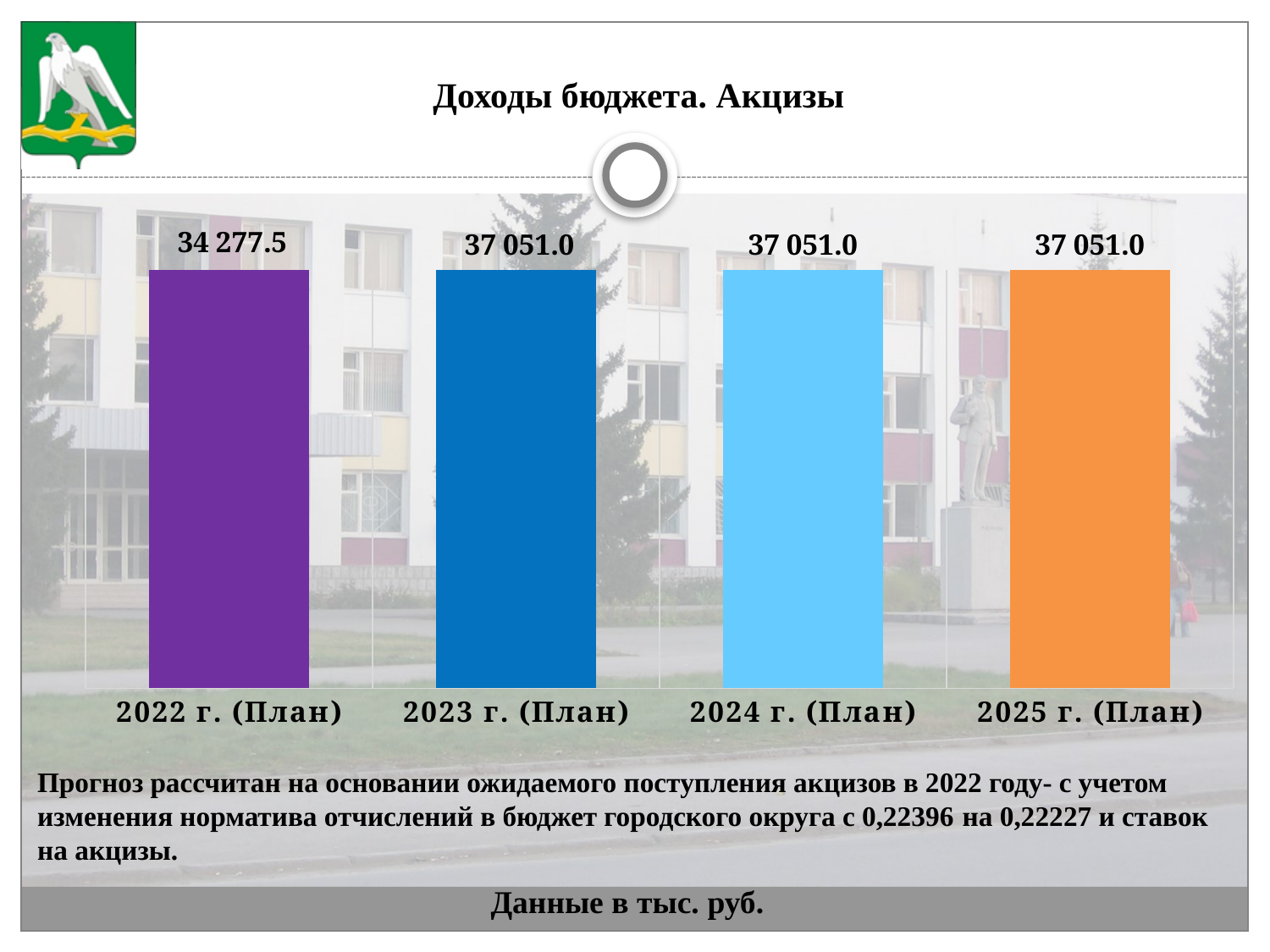
How many bars are shown in the chart? 4 What is the value for 2022 г. (План)? 34 277.5 In what units are the chart values given? тыс. руб. What is the value for 2025 г. (План)? 37 051.0 What is the difference between the values for 2023 г. (План) and 2022 г. (План)? 2 773.5 Does the value rise or fall from 2022 г. (План) to 2023 г. (План)? Rise What is the value for 2024 г. (План)? 37 051.0 What kind of chart is shown on the slide? Bar chart What is the value for 2023 г. (План)? 37 051.0 Which is larger, the value for 2022 г. (План) or the value for 2023 г. (План)? 2023 г. (План) What is the title of the chart? Доходы бюджета. Акцизы Which year has the lowest value? 2022 г. (План)